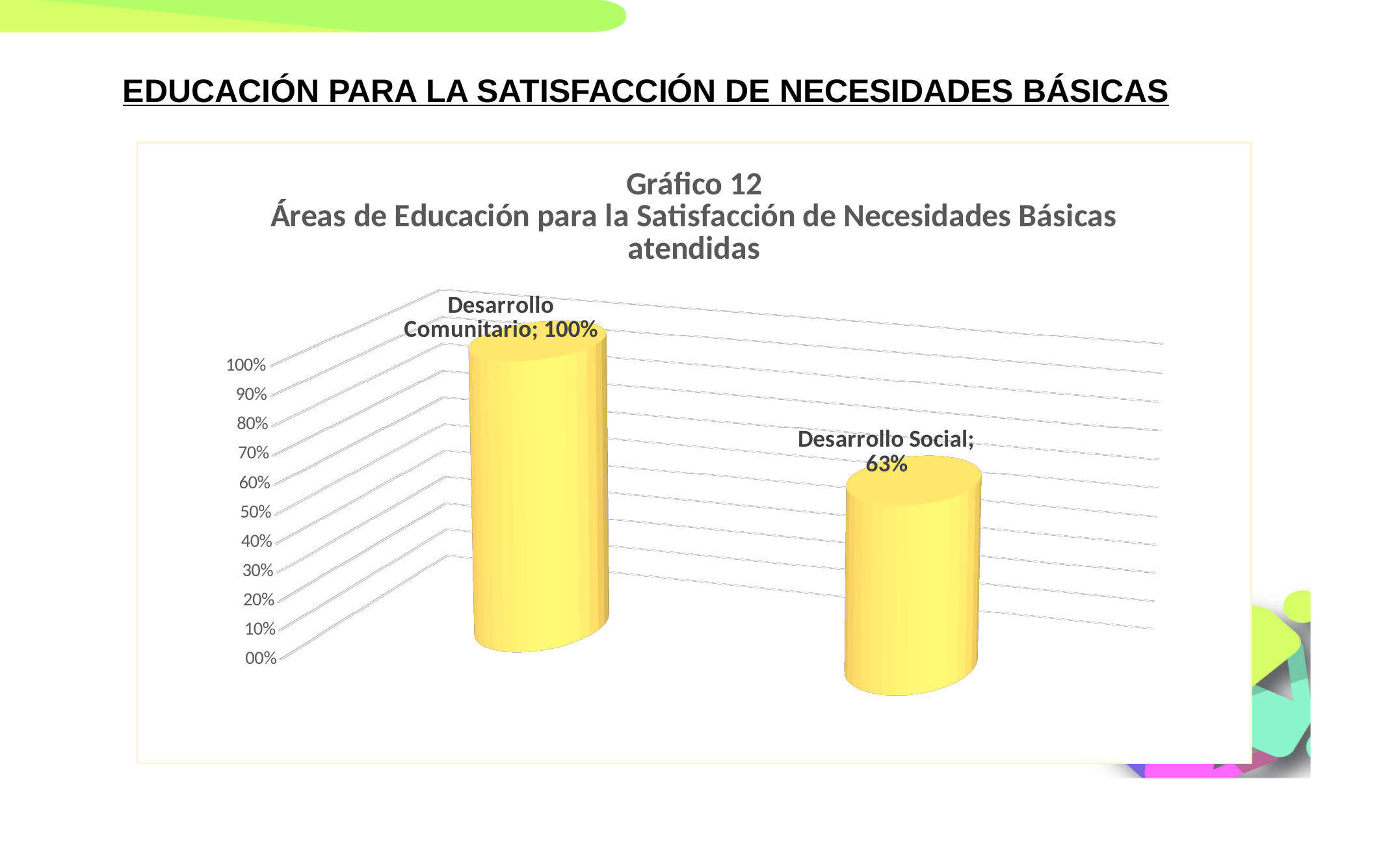
What is the highest value shown on the vertical axis? 100% What is the difference between the values for Desarrollo Comunitario and Desarrollo Social? 37% Which category has the lowest value? Desarrollo Social Which category has the highest value? Desarrollo Comunitario What is the title of the chart? Gráfico 12 Áreas de Educación para la Satisfacción de Necesidades Básicas atendidas What colour are the bars in the chart? yellow What is the value for Desarrollo Social? 63% Which is larger, the value for Desarrollo Comunitario or the value for Desarrollo Social? Desarrollo Comunitario What is the value for Desarrollo Comunitario? 100% What kind of chart is shown on the slide? bar chart Is the value for Desarrollo Social greater or less than 50%? greater How many categories are shown in the chart? 2